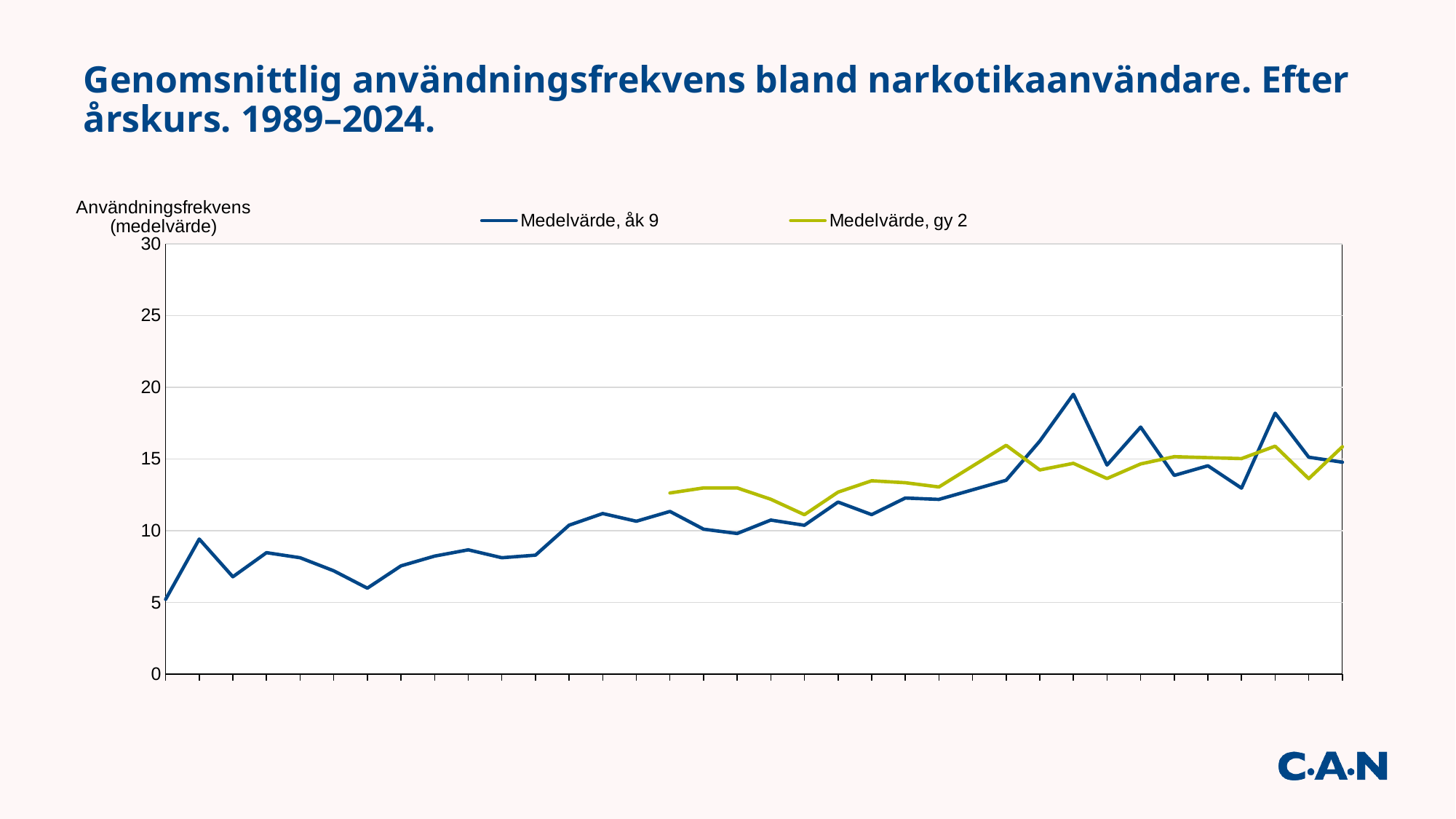
What are the two series named in the legend? Medelvärde, åk 9 and Medelvärde, gy 2 Is the last plotted value of Medelvärde, gy 2 greater or less than 15? greater Is the highest value reached by Medelvärde, gy 2 greater or less than 20? less Overall, does the Medelvärde, åk 9 line rise or fall from left to right? Rise What is the title of the chart on the slide? Genomsnittlig användningsfrekvens bland narkotikaanvändare. Efter årskurs. 1989–2024. Is the highest value reached by Medelvärde, åk 9 greater or less than 15? greater What kind of chart is shown on the slide? Line chart How many series does the legend list? 2 What is the maximum value shown on the vertical axis? 30 Which series reaches the higher peak value, Medelvärde, åk 9 or Medelvärde, gy 2? Medelvärde, åk 9